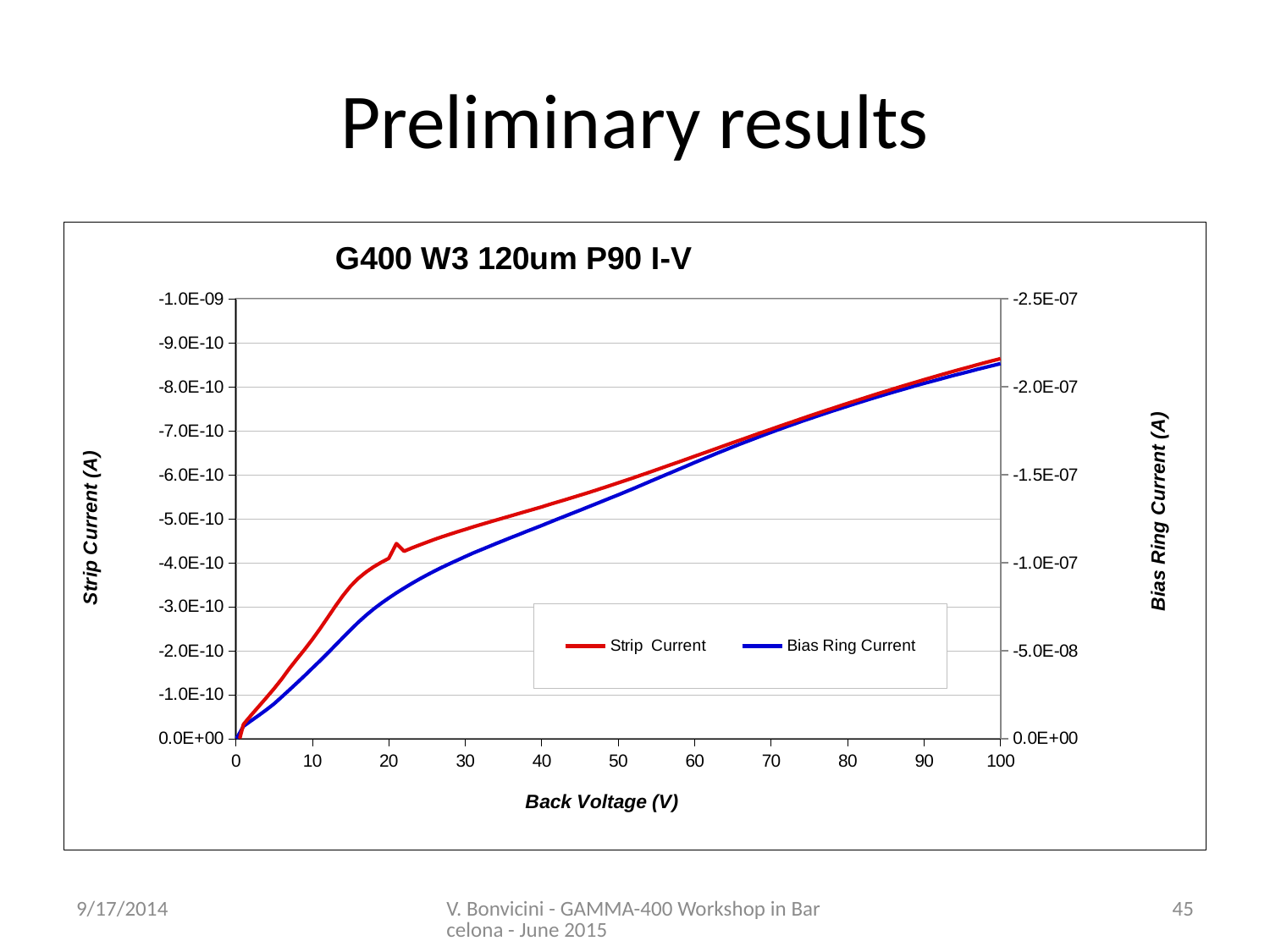
What kind of chart is shown on the slide? line chart What is the topmost tick value on the left-hand y axis? -1.0E-09 How many series does the legend list? 2 What is the label of the x axis? Back Voltage (V) What is the title of the chart? G400 W3 120um P90 I-V Which two series are listed in the legend? Strip Current and Bias Ring Current What is the label of the left-hand y axis? Strip Current (A) Does the magnitude of the Strip Current increase or decrease as Back Voltage increases from 0 to 100 V? increase What is the highest Back Voltage value shown on the x axis? 100 What is the topmost tick value on the right-hand y axis? -2.5E-07 What is the label of the right-hand y axis? Bias Ring Current (A) Does the magnitude of the Bias Ring Current increase or decrease as Back Voltage increases from 0 to 100 V? increase